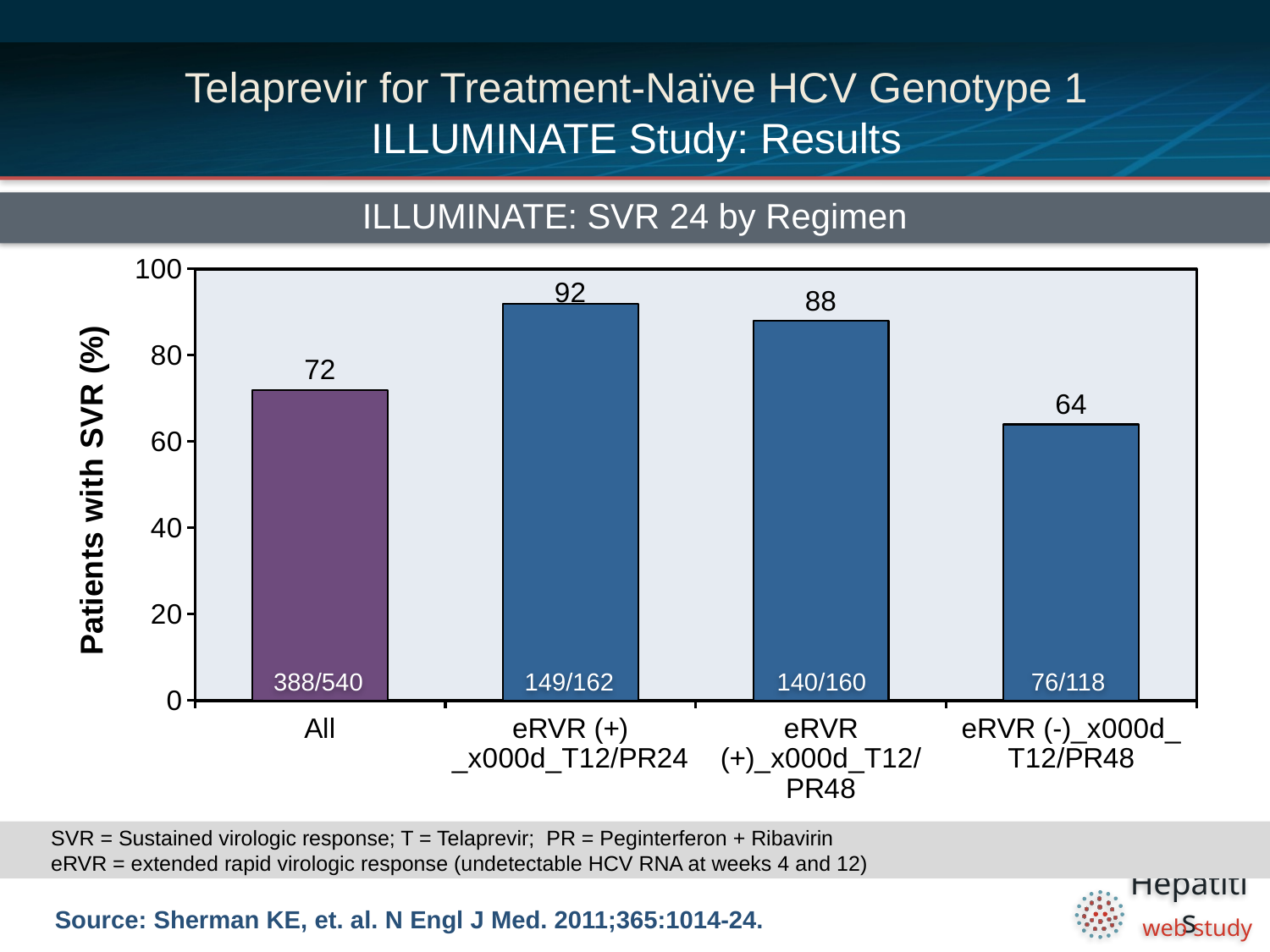
What kind of chart is shown on the slide? Bar chart What is the value for the eRVR (-) T12/PR48 group? 64 What fraction of patients is shown inside the bar for the eRVR (+) T12/PR48 group? 140/160 What is the value for the All group in the ILLUMINATE: SVR 24 by Regimen chart? 72 Which is larger, the value for All or the value for eRVR (-) T12/PR48? All What is the label of the y axis? Patients with SVR (%) What is the difference between the values for eRVR (+) T12/PR24 and eRVR (+) T12/PR48? 4 Which group has the lowest percentage of patients with SVR? eRVR (-) T12/PR48 What is the title of the chart? ILLUMINATE: SVR 24 by Regimen What is the value for the eRVR (+) T12/PR24 group? 92 How many groups (bars) are shown in the chart? 4 Which group has the highest percentage of patients with SVR? eRVR (+) T12/PR24